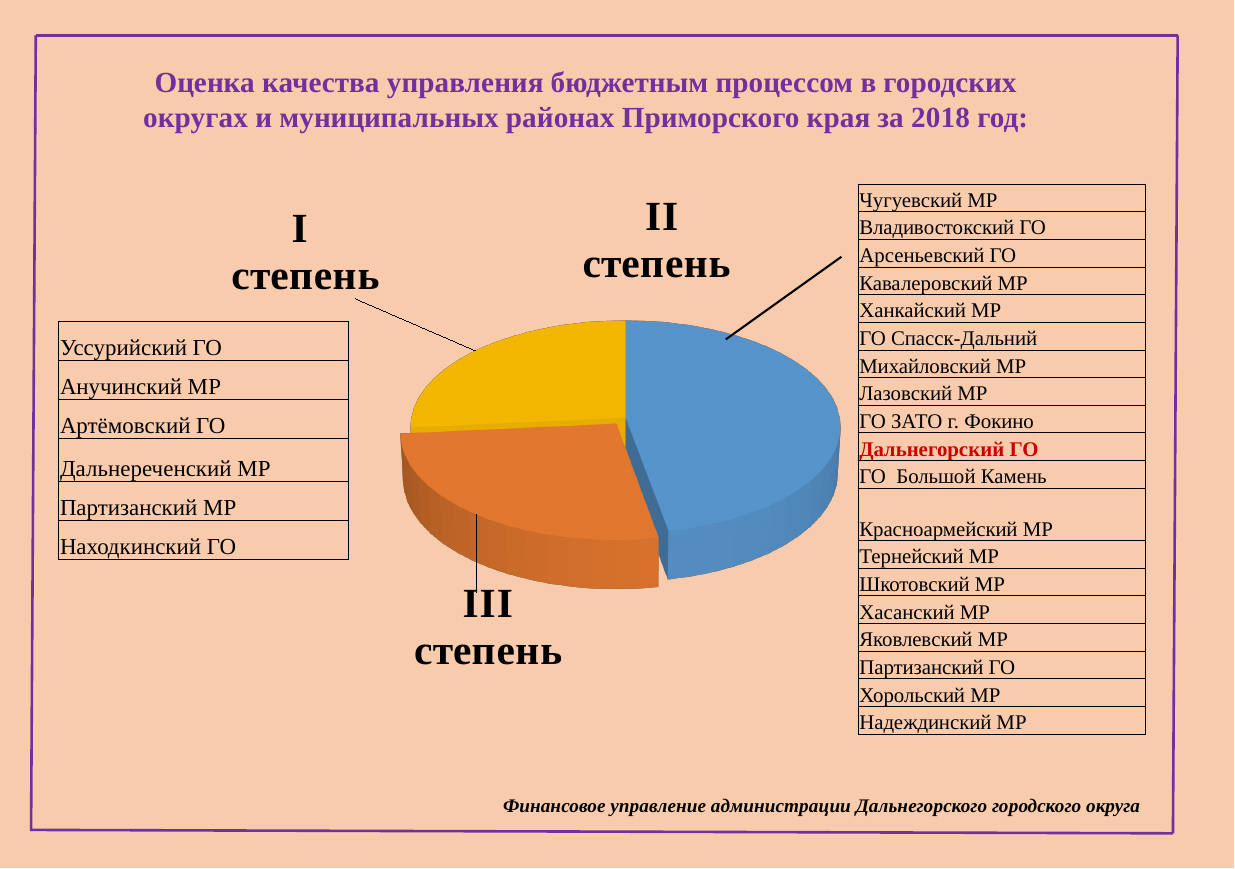
How many slices does the pie chart have? 3 Which slice is larger, II степень or I степень? II степень Which category has the largest slice of the pie chart? II степень How many municipalities are listed next to the II степень slice? 19 Which slice is larger, II степень or III степень? II степень Which category does Дальнегорский ГО belong to according to the slide? II степень Which category does Уссурийский ГО belong to according to the slide? I степень What colour is the slice for I степень? yellow How many municipalities are listed next to the I степень slice? 6 What kind of chart is shown on the slide? pie chart What colour is the slice for II степень? blue